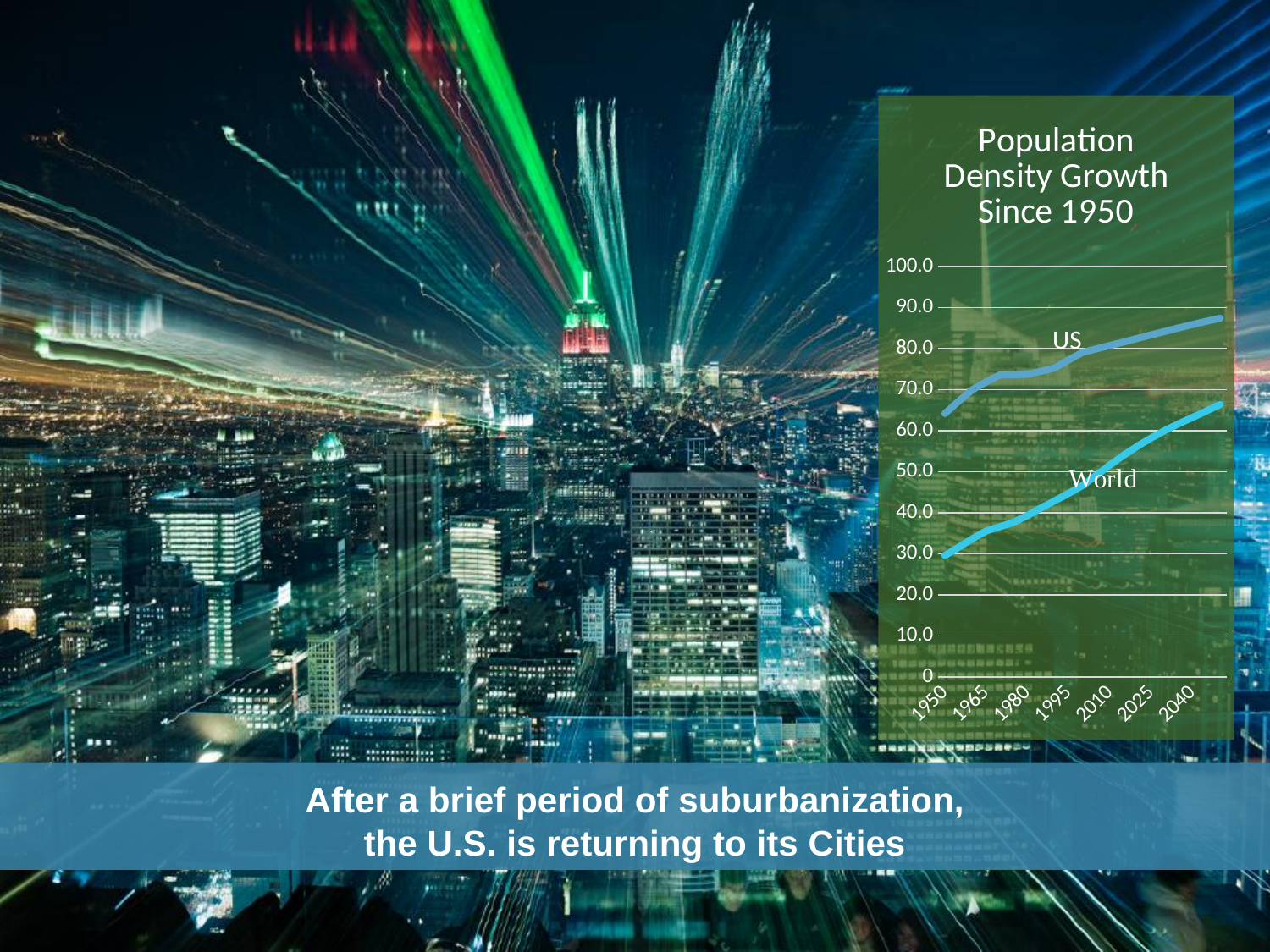
How many year labels are shown on the x axis? 7 What is the title of the chart? Population Density Growth Since 1950 Does the US line rise or fall from 1950 to 2040? rise What kind of chart is shown on the slide? line chart What are the names of the two series plotted on the chart? US and World Does the World line rise or fall from 1950 to 2040? rise How many series are plotted on the chart? 2 Which series has the higher value in 1950, US or World? US Is the value for US in 2040 greater or less than 80.0? greater Which series has the higher value in 2040, US or World? US Is the value for US in 1950 greater or less than 60.0? greater Is the value for World in 1950 greater or less than 40.0? less